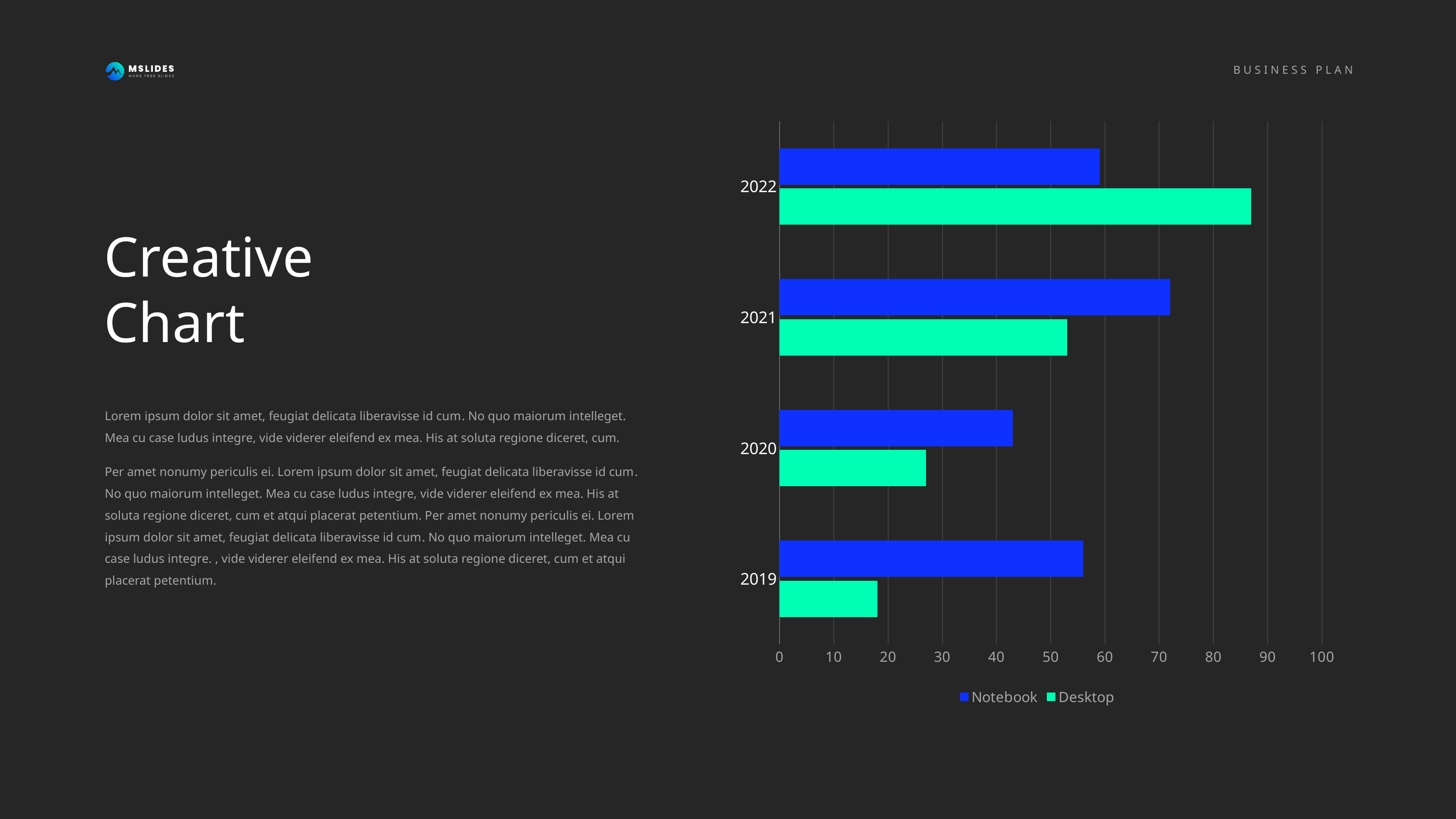
Is the Desktop value for 2022 greater or less than 80? greater Which series is shown in blue in the legend? Notebook In 2019, which is larger, Notebook or Desktop? Notebook How many years are shown on the chart? 4 How many series does the legend list? 2 What kind of chart is shown on the slide? bar chart In 2022, which is larger, Notebook or Desktop? Desktop Which year has the highest Notebook value? 2021 Which year has the highest Desktop value? 2022 Which year has the lowest Desktop value? 2019 Is the Desktop value for 2019 greater or less than 20? less Which year has the lowest Notebook value? 2020